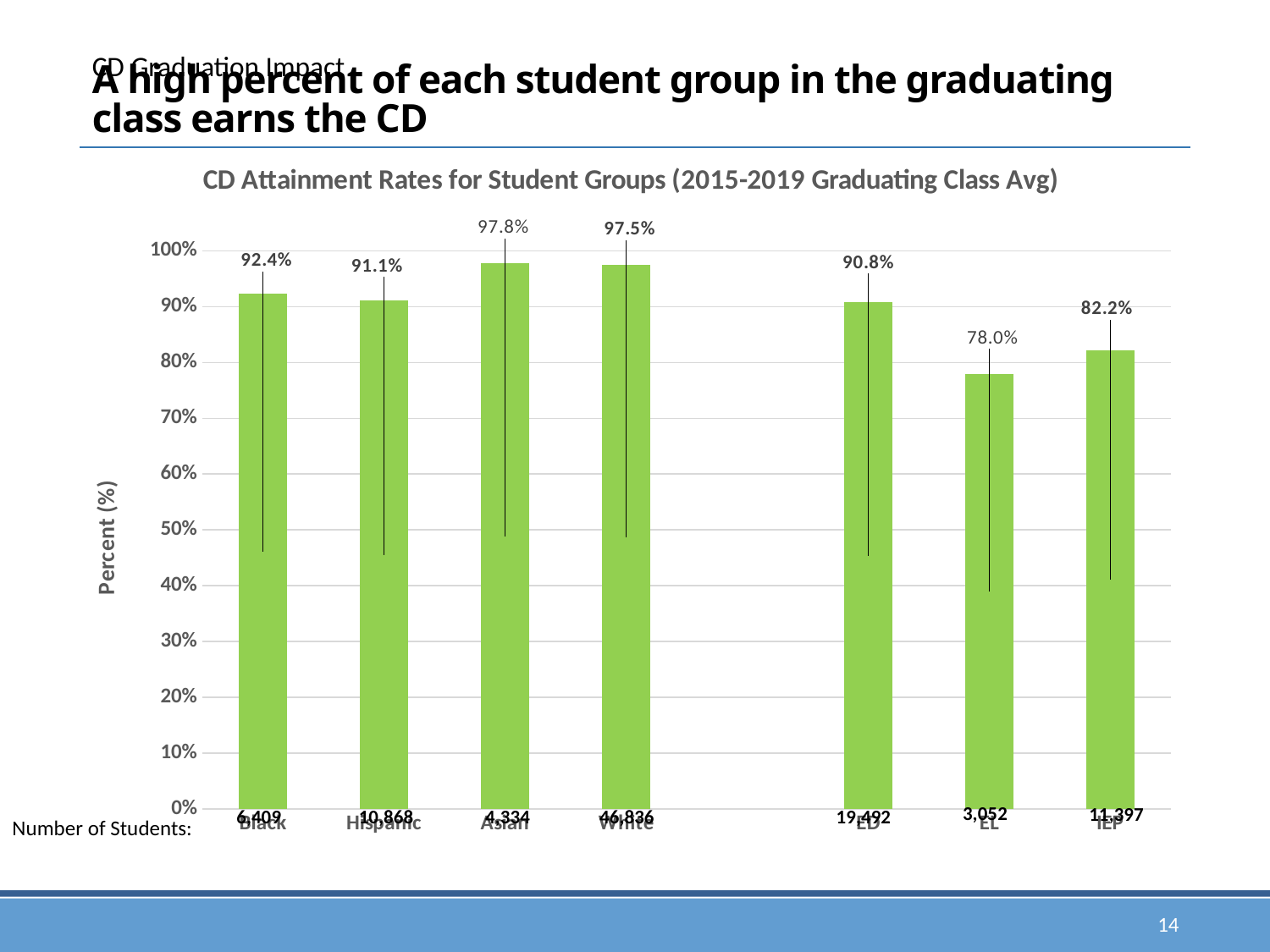
Which student group has the highest CD attainment rate? Asian What is the difference between the CD attainment rates for Black and Hispanic students? 1.3 percentage points What type of chart is used to show the CD attainment rates? Bar chart What is the difference between the CD attainment rates for Asian and EL students? 19.8 percentage points What is the CD attainment rate for ED students? 90.8% What is the CD attainment rate for EL students? 78.0% What is the CD attainment rate for IEP students? 82.2% How many student groups are shown in the chart? 7 Which has a higher CD attainment rate, Black students or ED students? Black What is the CD attainment rate for Black students? 92.4% Is the CD attainment rate for EL students greater or less than 80%? less Which student group has the lowest CD attainment rate? EL